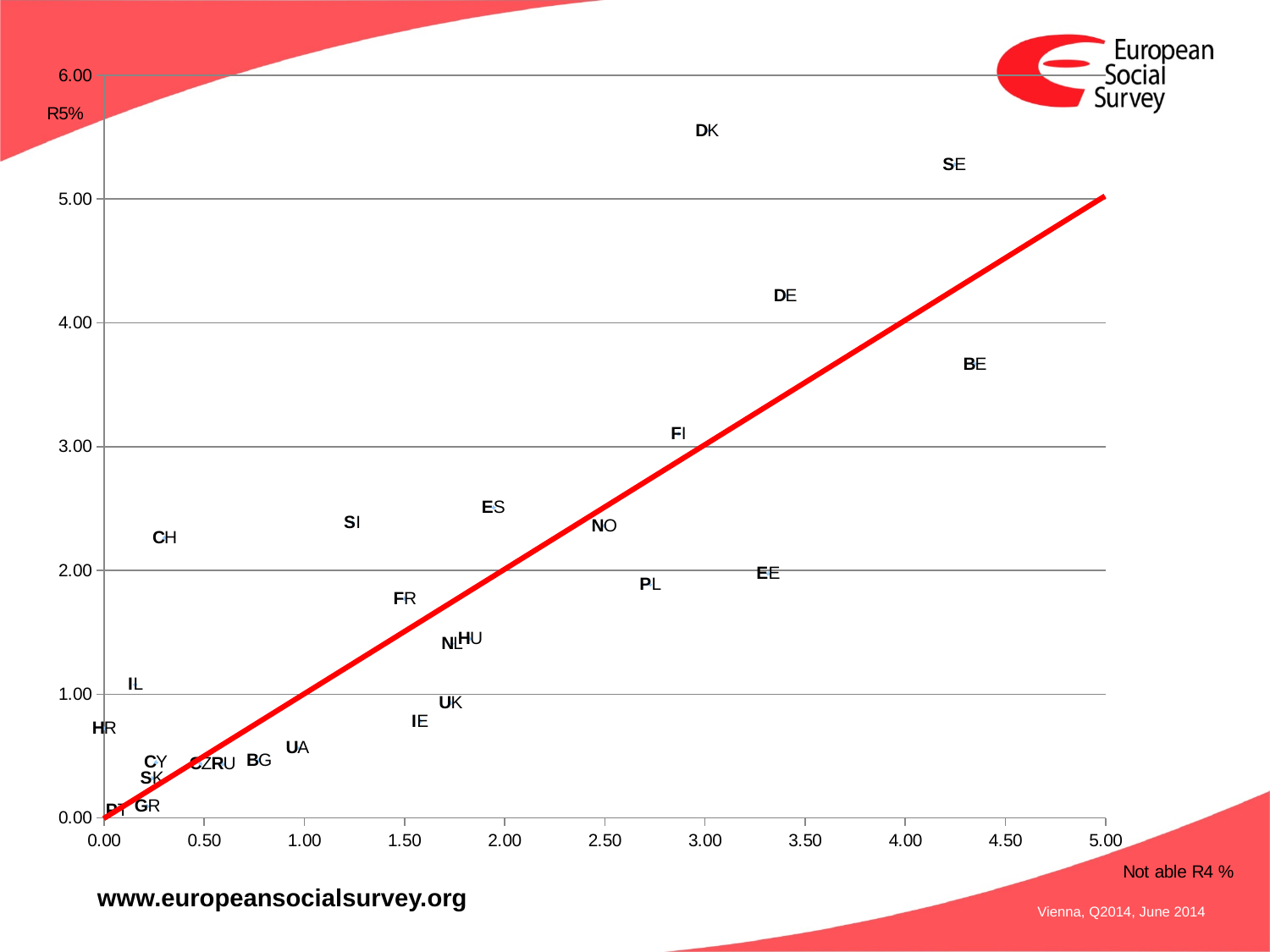
Is the R5% value for IE greater or less than 1.00? less Which country has the highest value on the vertical (R5%) axis? DK What is the label on the vertical axis of the chart? R5% Is the horizontal-axis (Not able R4 %) value for EE greater or less than 3.00? greater Is the R5% value for BE greater or less than 4.00? less What is the label on the horizontal axis of the chart? Not able R4 % What kind of chart is shown on the slide? scatter plot Which has the larger Not able R4 % value, SE or CH? SE Which has the higher R5% value, CH or IL? CH